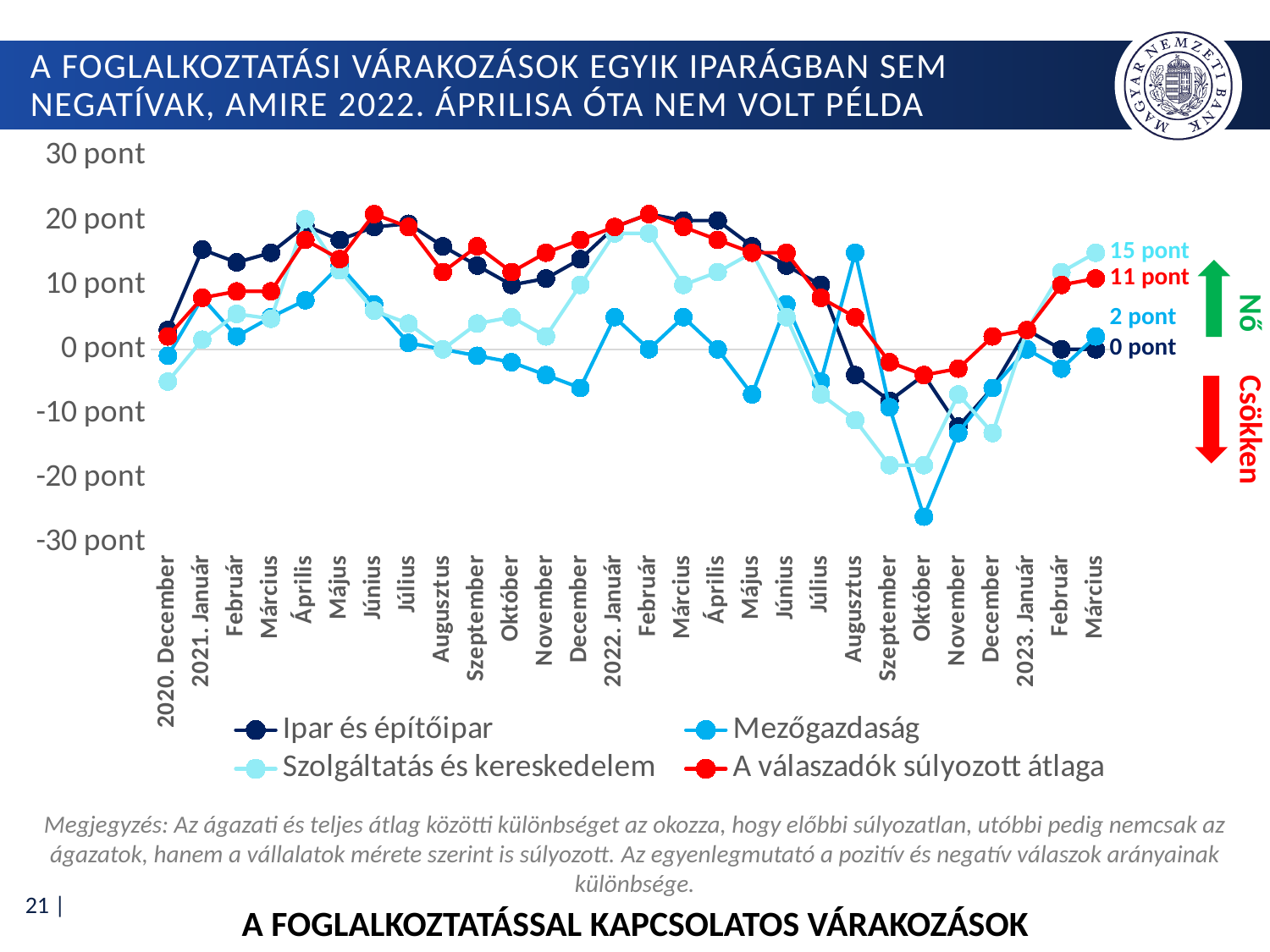
What is the title of the chart? A FOGLALKOZTATÁSSAL KAPCSOLATOS VÁRAKOZÁSOK Is the value for Mezőgazdaság in 2022. Október greater or less than -20 pont? less What is the difference between Szolgáltatás és kereskedelem and A válaszadók súlyozott átlaga in 2023. Március? 4 pont What kind of chart is shown on the slide? line chart What is the value for Mezőgazdaság in 2023. Március? 2 pont How many series does the legend list? 4 Which series has the highest value in 2023. Március? Szolgáltatás és kereskedelem Is the value for A válaszadók súlyozott átlaga in 2022. Február greater or less than 10 pont? greater What is the value for A válaszadók súlyozott átlaga in 2023. Március? 11 pont What is the value for Szolgáltatás és kereskedelem in 2023. Március? 15 pont Which series has the lowest value in 2023. Március? Ipar és építőipar What is the value for Ipar és építőipar in 2023. Március? 0 pont